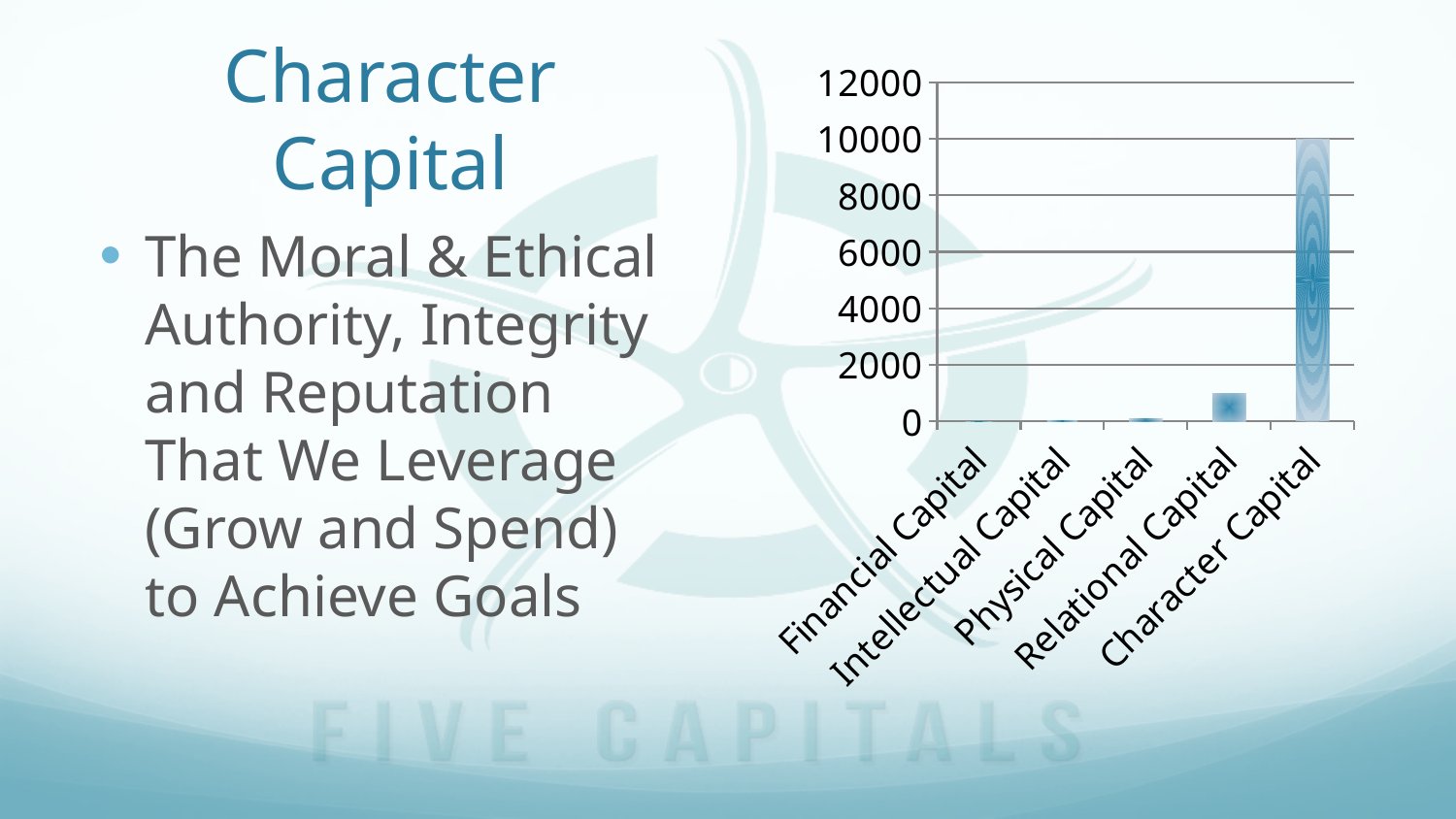
What is the value for Character Capital on the chart? 10000 How many categories are plotted on the chart? 5 Is the value for Relational Capital greater or less than 2000? less Do the values rise or fall moving from left to right along the x axis? rise Is the value for Physical Capital greater or less than 2000? less Is the value for Character Capital greater or less than 8000? greater Which category has the highest value on the chart? Character Capital Which is larger, the value for Relational Capital or the value for Character Capital? Character Capital What is the highest value shown on the vertical axis of the chart? 12000 What kind of chart is shown on the slide? bar chart What is the label of the rightmost category on the x axis? Character Capital Which is larger, the value for Relational Capital or the value for Physical Capital? Relational Capital